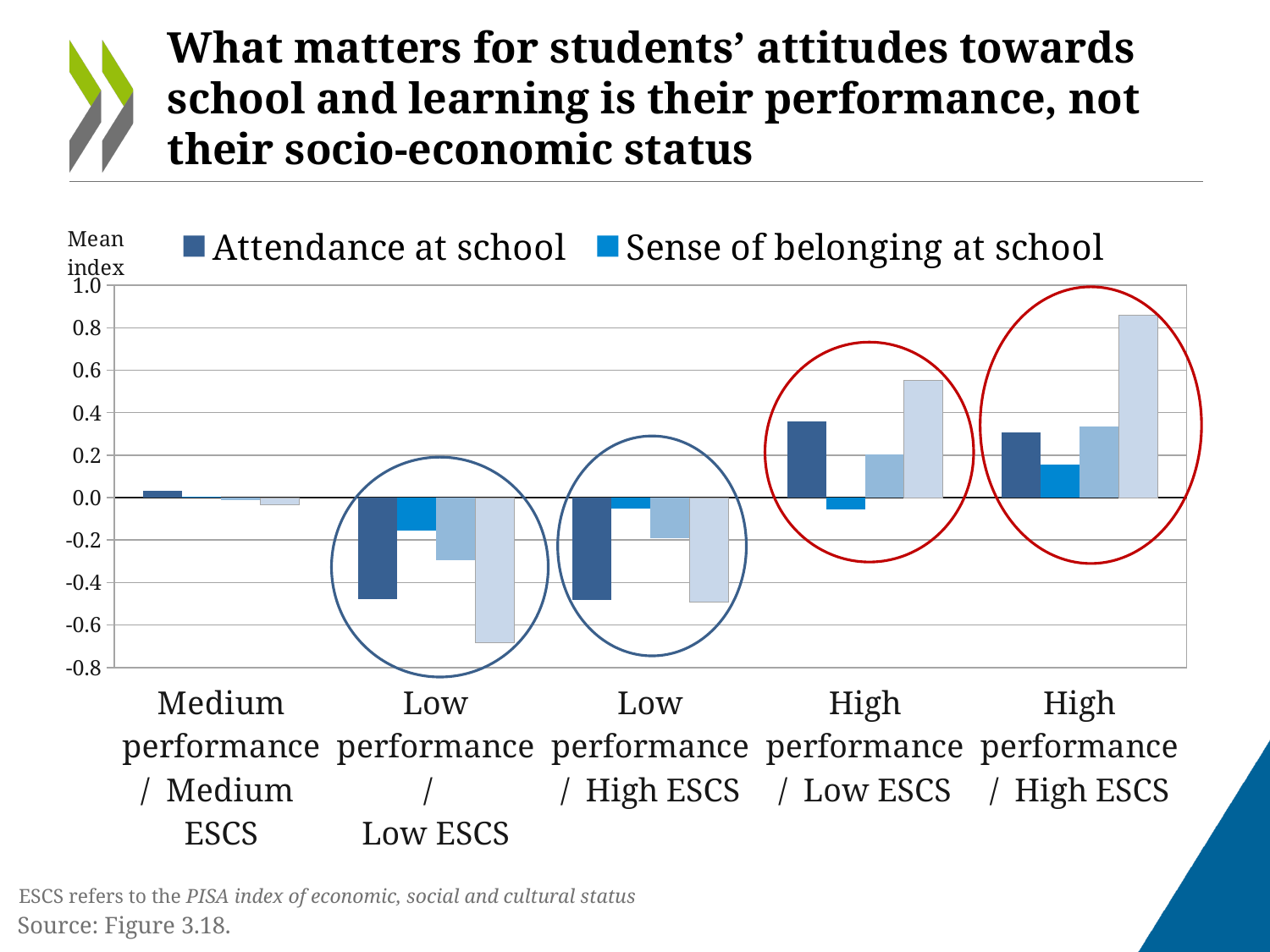
What are the two series named in the chart's legend? Attendance at school; Sense of belonging at school What kind of chart is shown on the slide? bar chart Which is larger: Attendance at school for High performance / Low ESCS or Attendance at school for Low performance / Low ESCS? High performance / Low ESCS What is the label on the vertical axis of the chart? Mean index How many categories are shown on the x axis of the chart? 5 Which is larger: Sense of belonging at school for High performance / High ESCS or Sense of belonging at school for Low performance / Low ESCS? High performance / High ESCS Is the value of Attendance at school for Low performance / Low ESCS greater or less than -0.4? less Is the value of Attendance at school for High performance / Low ESCS greater or less than 0.2? greater Is the value of Attendance at school for Medium performance / Medium ESCS greater or less than 0.2? less How many series does the chart's legend list? 2